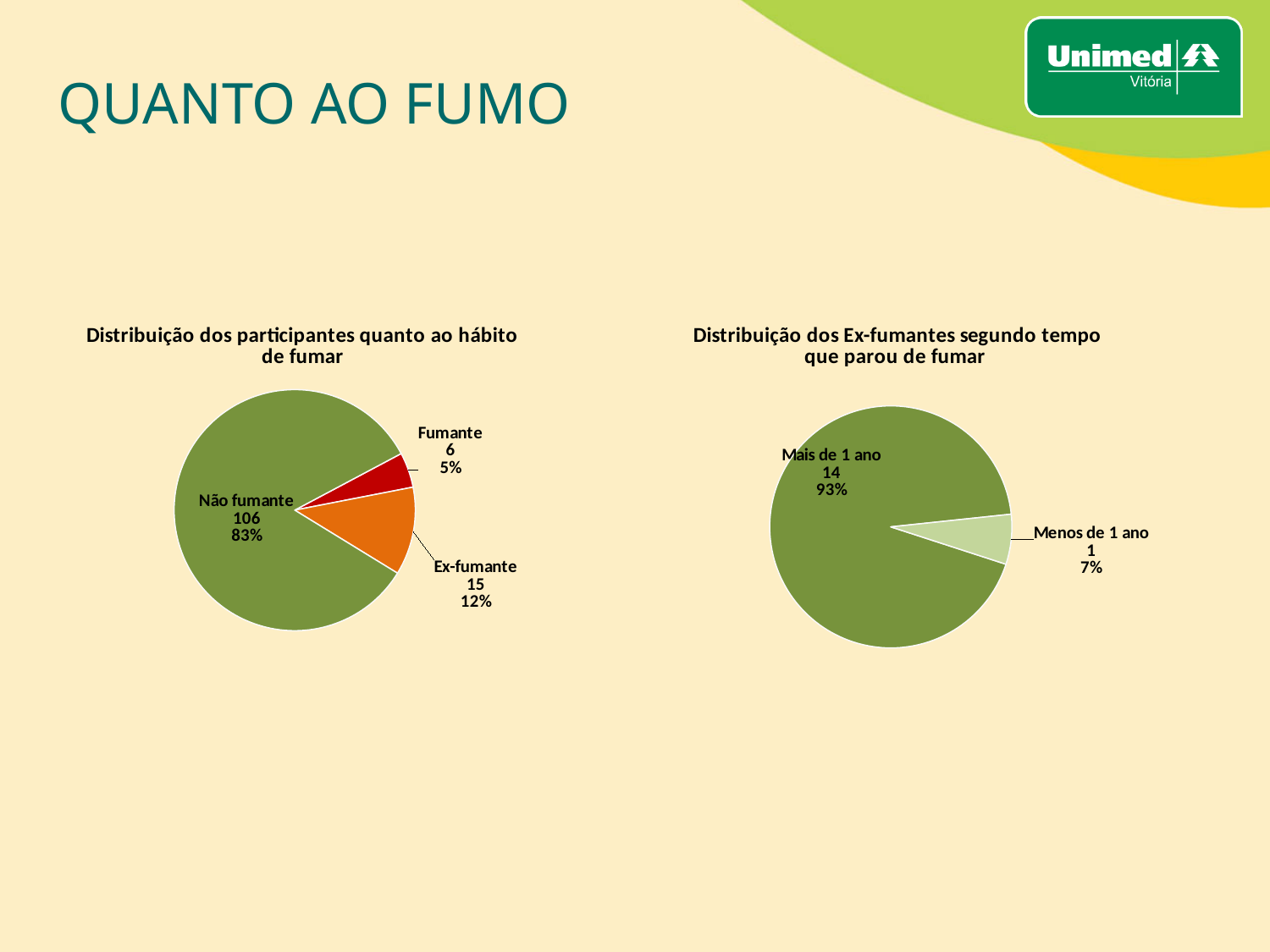
What type of chart is the left chart 'Distribuição dos participantes quanto ao hábito de fumar'? Pie chart In the left chart 'Distribuição dos participantes quanto ao hábito de fumar', which category has the largest slice? Não fumante In the left chart 'Distribuição dos participantes quanto ao hábito de fumar', how many participants are 'Não fumante'? 106 In the right chart 'Distribuição dos Ex-fumantes segundo tempo que parou de fumar', which category is larger, 'Mais de 1 ano' or 'Menos de 1 ano'? Mais de 1 ano In the left chart 'Distribuição dos participantes quanto ao hábito de fumar', how many categories are shown? 3 In the right chart 'Distribuição dos Ex-fumantes segundo tempo que parou de fumar', how many categories are shown? 2 In the left chart 'Distribuição dos participantes quanto ao hábito de fumar', what is the difference in count between 'Ex-fumante' and 'Fumante'? 9 In the left chart 'Distribuição dos participantes quanto ao hábito de fumar', what colour is the 'Fumante' slice? Red In the right chart 'Distribuição dos Ex-fumantes segundo tempo que parou de fumar', what percentage is 'Menos de 1 ano'? 7% In the left chart 'Distribuição dos participantes quanto ao hábito de fumar', which category has the smallest slice? Fumante In the right chart 'Distribuição dos Ex-fumantes segundo tempo que parou de fumar', how many ex-smokers stopped 'Mais de 1 ano' ago? 14 In the left chart 'Distribuição dos participantes quanto ao hábito de fumar', what percentage of participants are 'Ex-fumante'? 12%